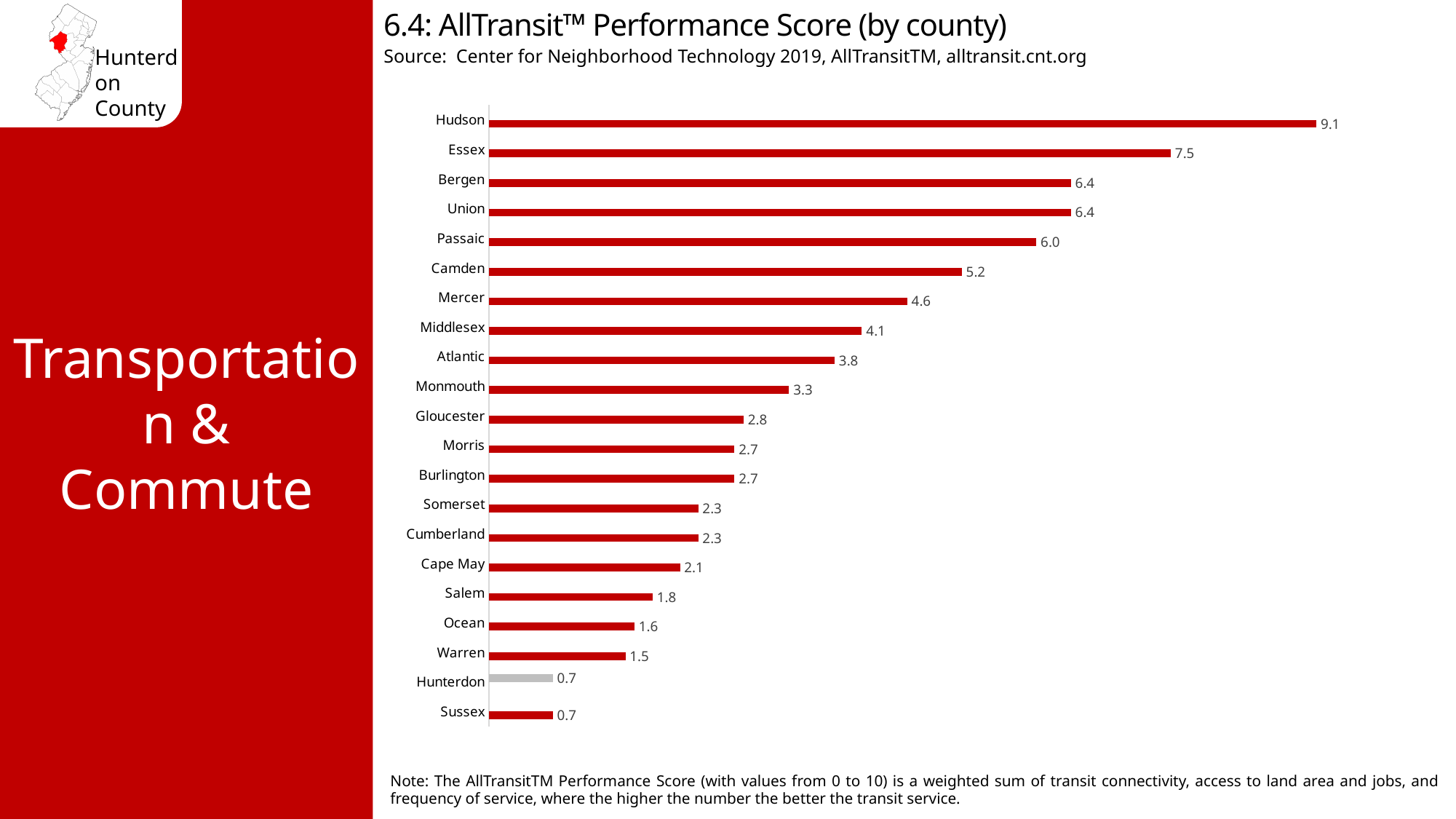
What type of chart is used to show the AllTransit Performance Score by county? Bar chart What is the AllTransit Performance Score for Hudson County? 9.1 Which county has a higher AllTransit Performance Score, Camden or Middlesex? Camden What is the difference between the AllTransit Performance Scores of Hudson and Essex counties? 1.6 How many counties are shown in the chart? 21 What is the AllTransit Performance Score for Mercer County? 4.6 Which county has the highest AllTransit Performance Score? Hudson What is the difference between the AllTransit Performance Scores of Passaic and Hunterdon counties? 5.3 Which county's bar is shown in gray rather than red? Hunterdon What is the AllTransit Performance Score for Cape May County? 2.1 Which county has a higher AllTransit Performance Score, Warren or Salem? Salem What is the AllTransit Performance Score for Hunterdon County? 0.7